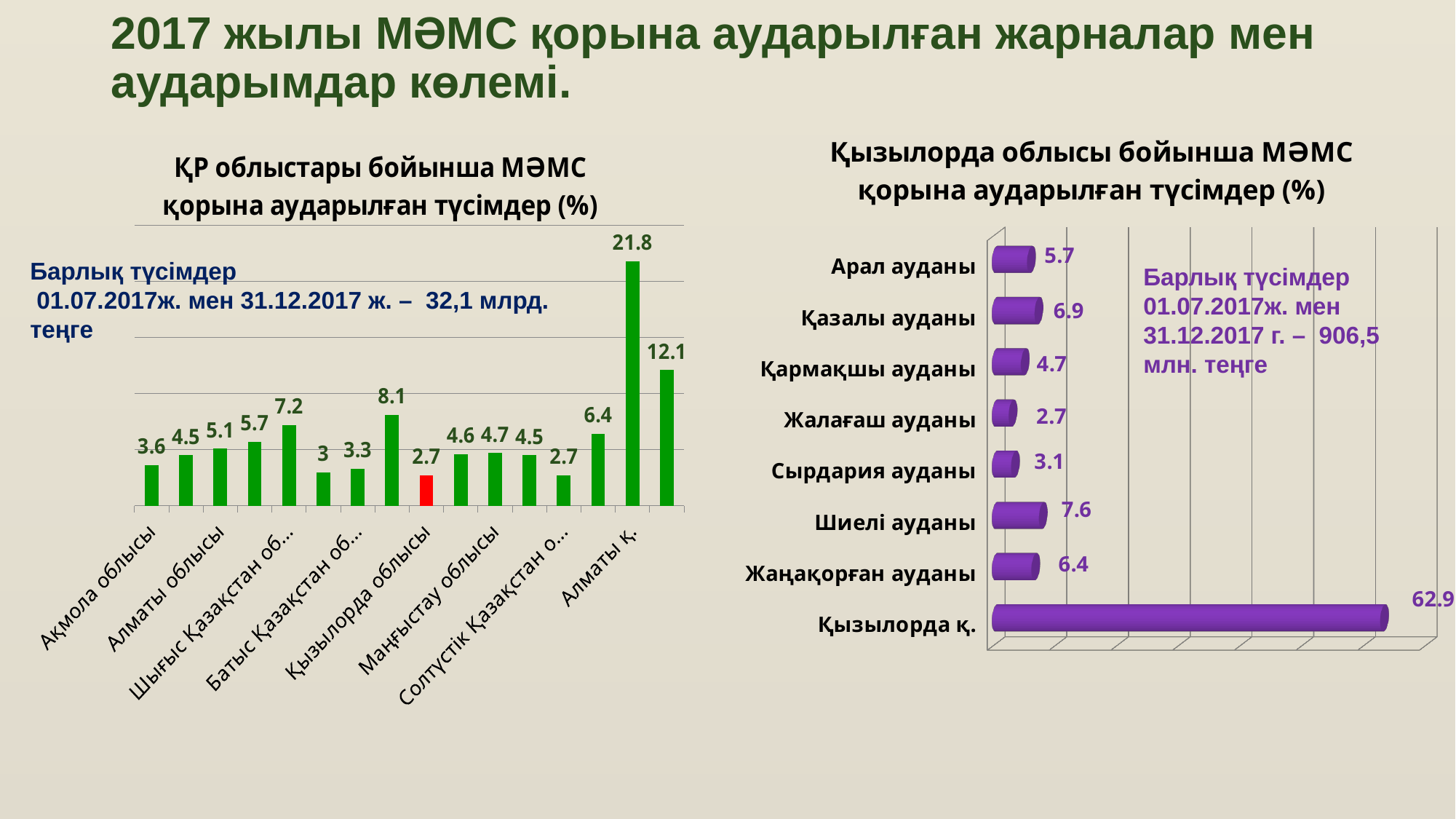
In the right chart (Қызылорда облысы бойынша МӘМС қорына аударылған түсімдер), what is the value for Шиелі ауданы? 7.6 In the right chart (Қызылорда облысы бойынша МӘМС қорына аударылған түсімдер), how many categories are shown? 8 In the left chart (ҚР облыстары бойынша МӘМС қорына аударылған түсімдер), what is the highest value shown? 21.8 In the right chart (Қызылорда облысы бойынша МӘМС қорына аударылған түсімдер), what is the value for Арал ауданы? 5.7 In the left chart (ҚР облыстары бойынша МӘМС қорына аударылған түсімдер), what is the value for Қызылорда облысы (the red bar)? 2.7 What kind of chart is the right chart (Қызылорда облысы бойынша МӘМС қорына аударылған түсімдер)? Bar chart In the left chart (ҚР облыстары бойынша МӘМС қорына аударылған түсімдер), how many bars are plotted? 16 In the right chart (Қызылорда облысы бойынша МӘМС қорына аударылған түсімдер), what is the difference between the values for Қазалы ауданы and Жаңақорған ауданы? 0.5 In the left chart (ҚР облыстары бойынша МӘМС қорына аударылған түсімдер), which category's bar is coloured red? Қызылорда облысы In the right chart (Қызылорда облысы бойынша МӘМС қорына аударылған түсімдер), which category has the lowest value? Жалағаш ауданы In the right chart (Қызылорда облысы бойынша МӘМС қорына аударылған түсімдер), which category has the highest value? Қызылорда қ. In the right chart (Қызылорда облысы бойынша МӘМС қорына аударылған түсімдер), which is larger: the value for Қармақшы ауданы or for Сырдария ауданы? Қармақшы ауданы